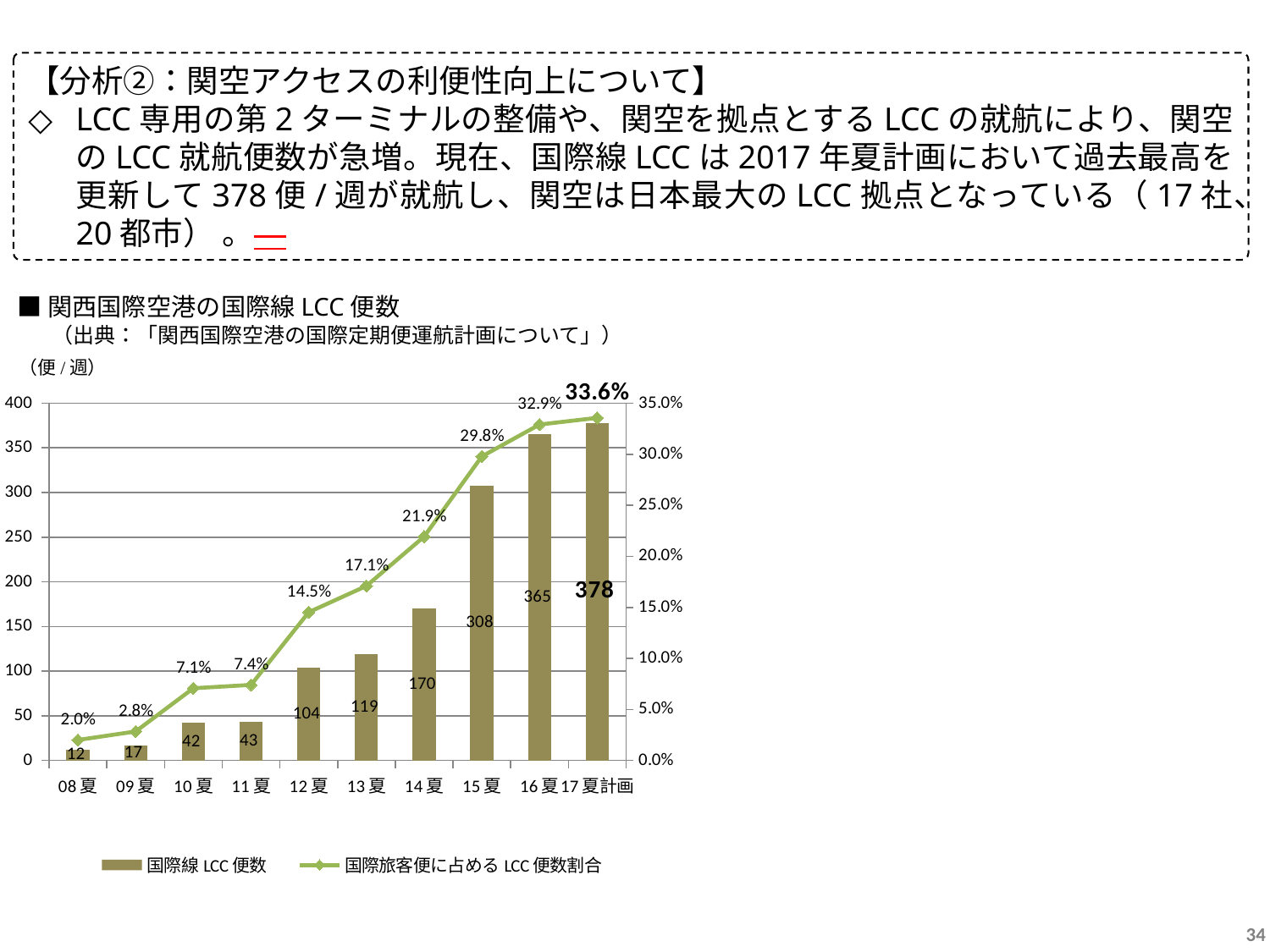
What is the unit shown above the left axis of the chart? 便/週 What is the difference in 国際線LCC便数 between 16夏 and 15夏? 57 Does the 国際旅客便に占めるLCC便数割合 rise or fall from 08夏 to 17夏計画? rise What kind of chart is used to show 国際線LCC便数? bar chart Which category has the lowest 国際線LCC便数? 08夏 How many categories are shown on the x axis? 10 How many series does the legend list? 2 What is the value of 国際線LCC便数 for 15夏? 308 Which is larger, the 国際線LCC便数 for 13夏 or for 14夏? 14夏 Which category has the highest 国際旅客便に占めるLCC便数割合? 17夏計画 What is the value of 国際線LCC便数 for 17夏計画? 378 What is the 国際旅客便に占めるLCC便数割合 for 14夏? 21.9%